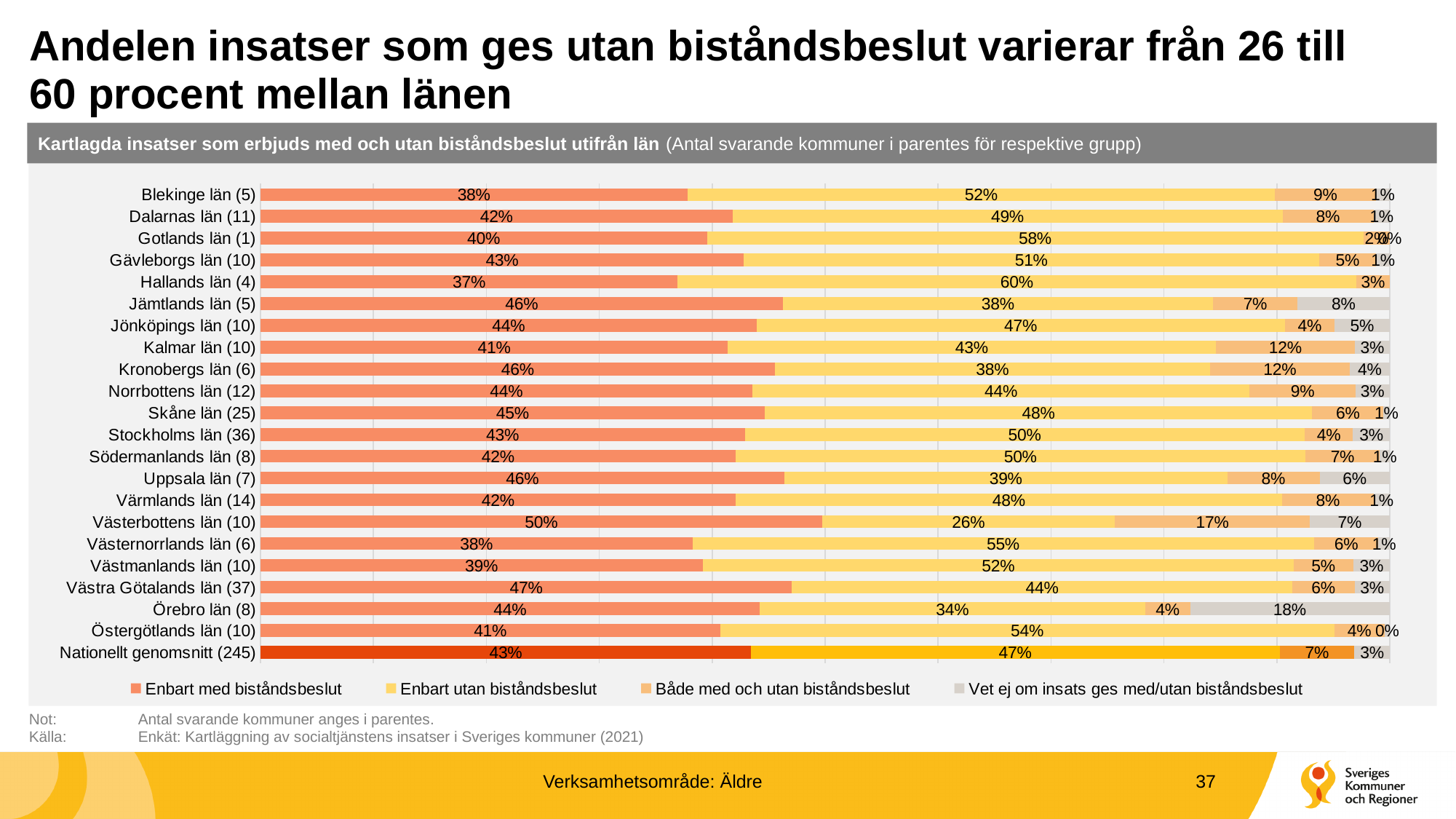
What is the difference in 'Enbart utan biståndsbeslut' between Hallands län (4) and Västerbottens län (10)? 34 percentage points What is the value of 'Enbart utan biståndsbeslut' for Hallands län (4)? 60% What is the value of 'Vet ej om insats ges med/utan biståndsbeslut' for Örebro län (8)? 18% What kind of chart is shown on the slide? Stacked bar chart How many series does the legend list? 4 Which län has the highest value for 'Enbart utan biståndsbeslut'? Hallands län (4) What is the value of 'Enbart med biståndsbeslut' for Nationellt genomsnitt (245)? 43% What is the value of 'Enbart utan biståndsbeslut' for Västerbottens län (10)? 26% How many categories (rows) are plotted in the chart, including the national average? 22 Which has a larger value for 'Enbart med biståndsbeslut': Jämtlands län (5) or Blekinge län (5)? Jämtlands län (5) Which län has the highest value for 'Enbart med biståndsbeslut'? Västerbottens län (10) Which län has the lowest value for 'Enbart utan biståndsbeslut'? Västerbottens län (10)